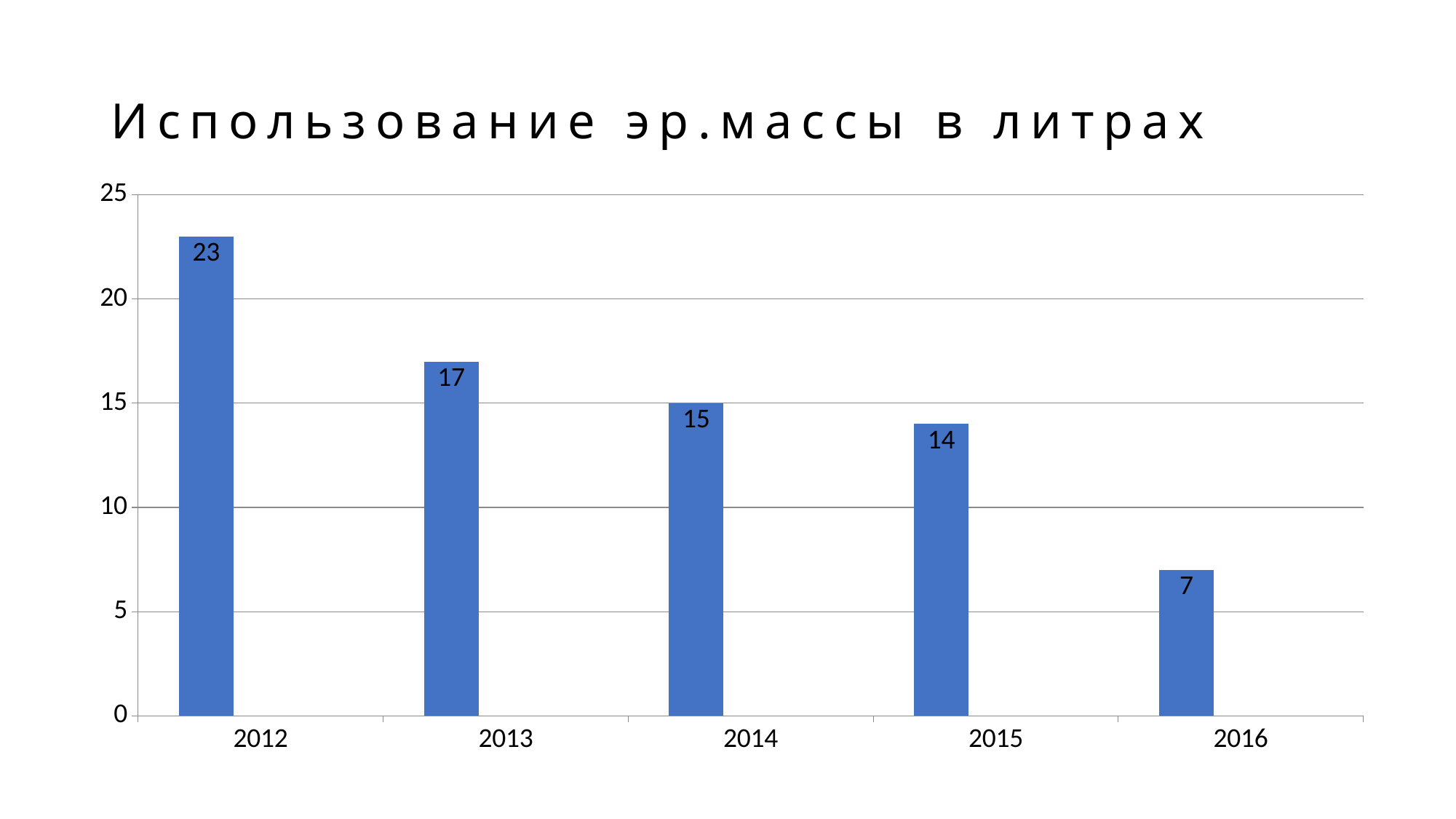
Do the values rise or fall from 2012 to 2016? fall Which year has the lowest value? 2016 Which is larger, the value for 2013 or the value for 2015? 2013 What is the difference between the values for 2015 and 2016? 7 What is the value for 2014? 15 What kind of chart is shown on the slide? bar chart What is the difference between the values for 2012 and 2013? 6 Which year has the highest value? 2012 What is the value for 2016? 7 How many years are shown on the x axis? 5 Is the value for 2012 greater or less than 20? greater What is the value for 2012? 23